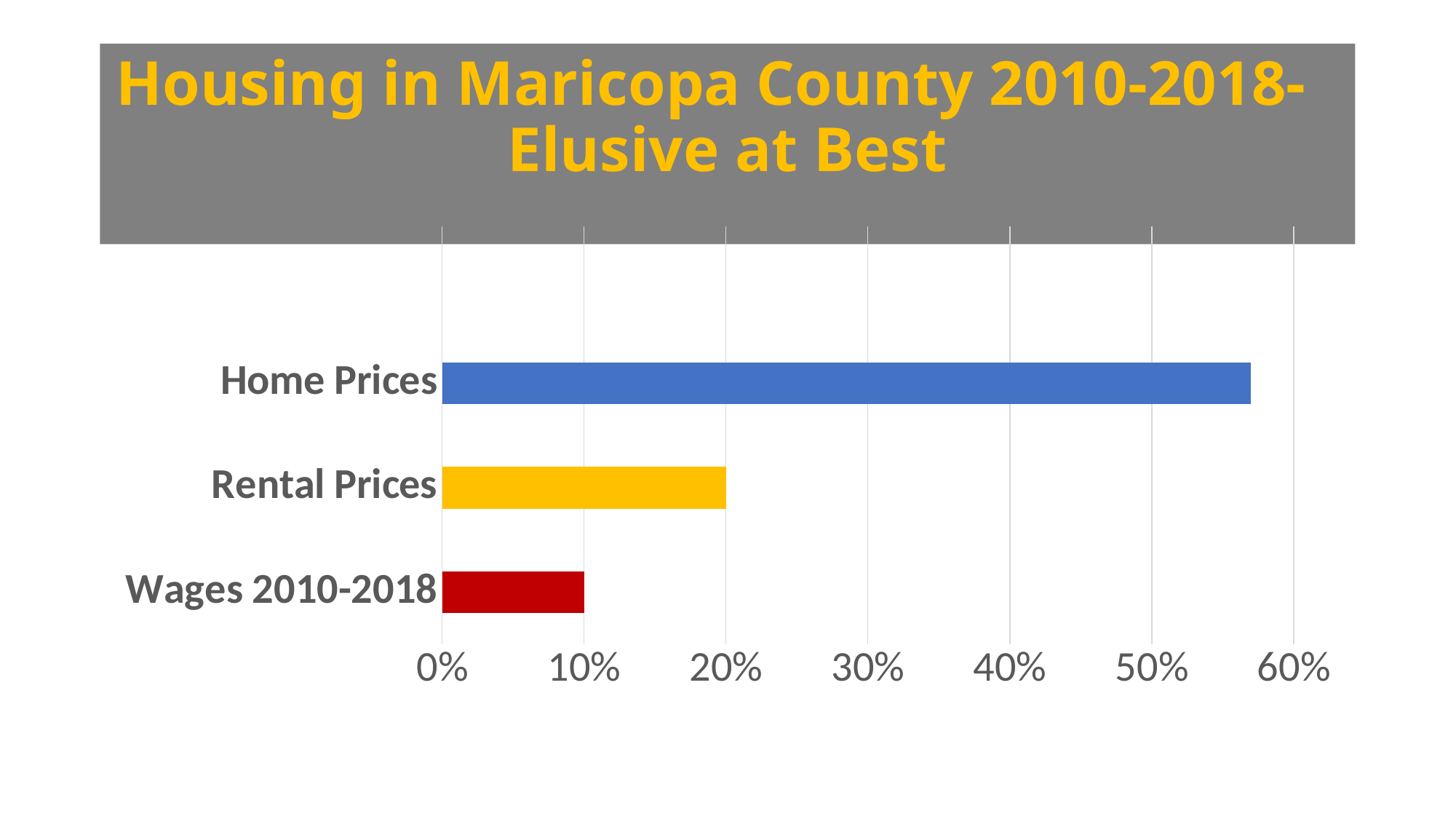
What colour is the bar for Wages 2010-2018? red What is the value for Wages 2010-2018? 10% Which category has the highest value? Home Prices How many categories are plotted in the chart? 3 What kind of chart is shown on the slide? bar chart Is the value for Home Prices greater or less than 50%? greater Which is larger, the value for Rental Prices or the value for Wages 2010-2018? Rental Prices Is the value for Home Prices greater or less than 60%? less What is the title of the slide? Housing in Maricopa County 2010-2018- Elusive at Best What is the difference between the value for Rental Prices and the value for Wages 2010-2018? 10% What is the value for Rental Prices? 20% Which category has the lowest value? Wages 2010-2018